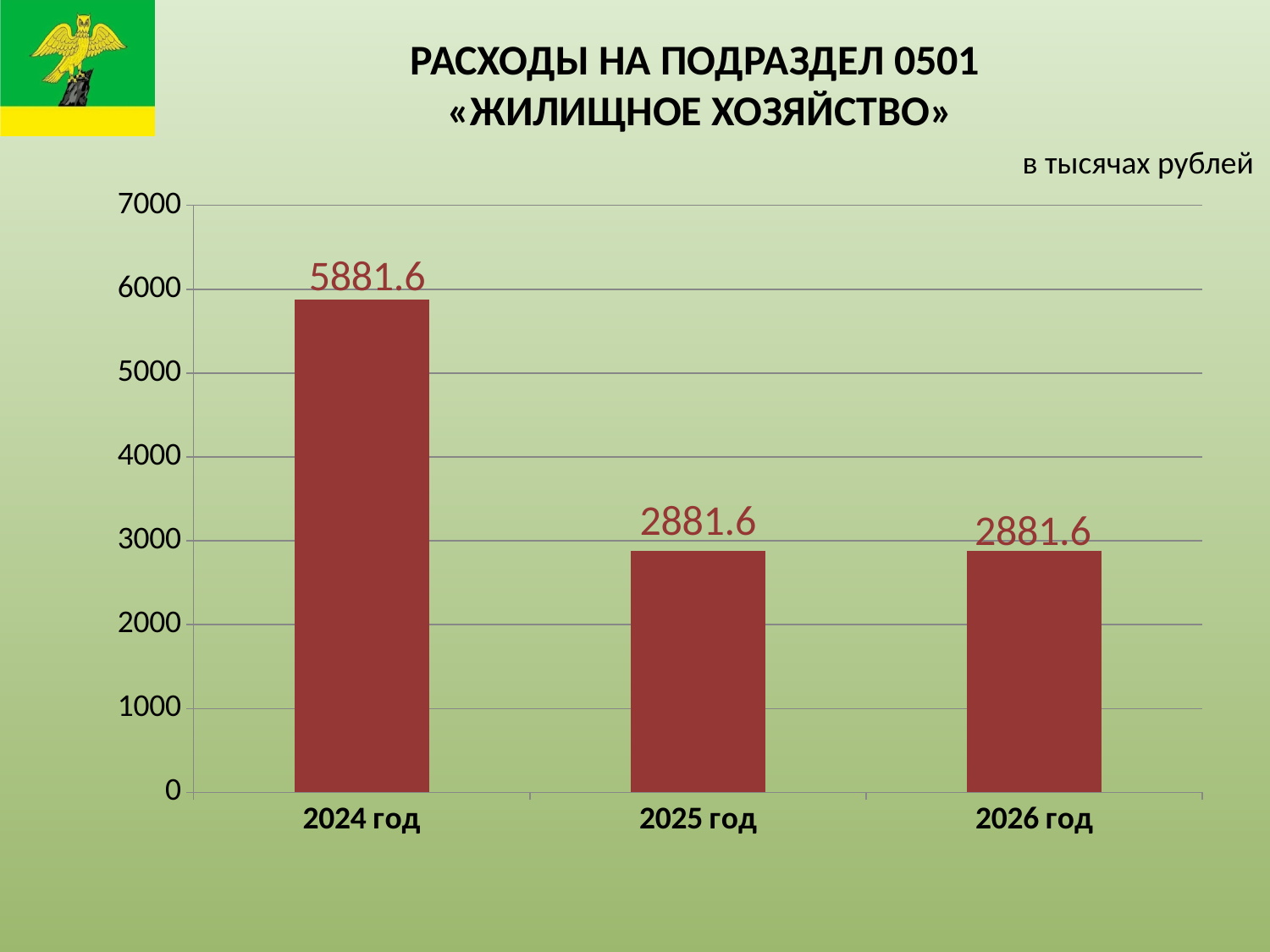
Is the value for 2025 год greater or less than 3000? less Which is larger, the value for 2024 год or the value for 2026 год? 2024 год What is the value for 2026 год? 2881.6 What is the value for 2025 год? 2881.6 In what units are the values given, according to the note above the chart? в тысячах рублей Do the values rise or fall from 2024 год to 2025 год? fall Is the value for 2024 год greater or less than 5000? greater What kind of chart is shown on the slide? bar chart Which year has the highest value? 2024 год How many years are shown on the x axis? 3 What is the value for 2024 год? 5881.6 What is the difference between the values for 2024 год and 2025 год? 3000